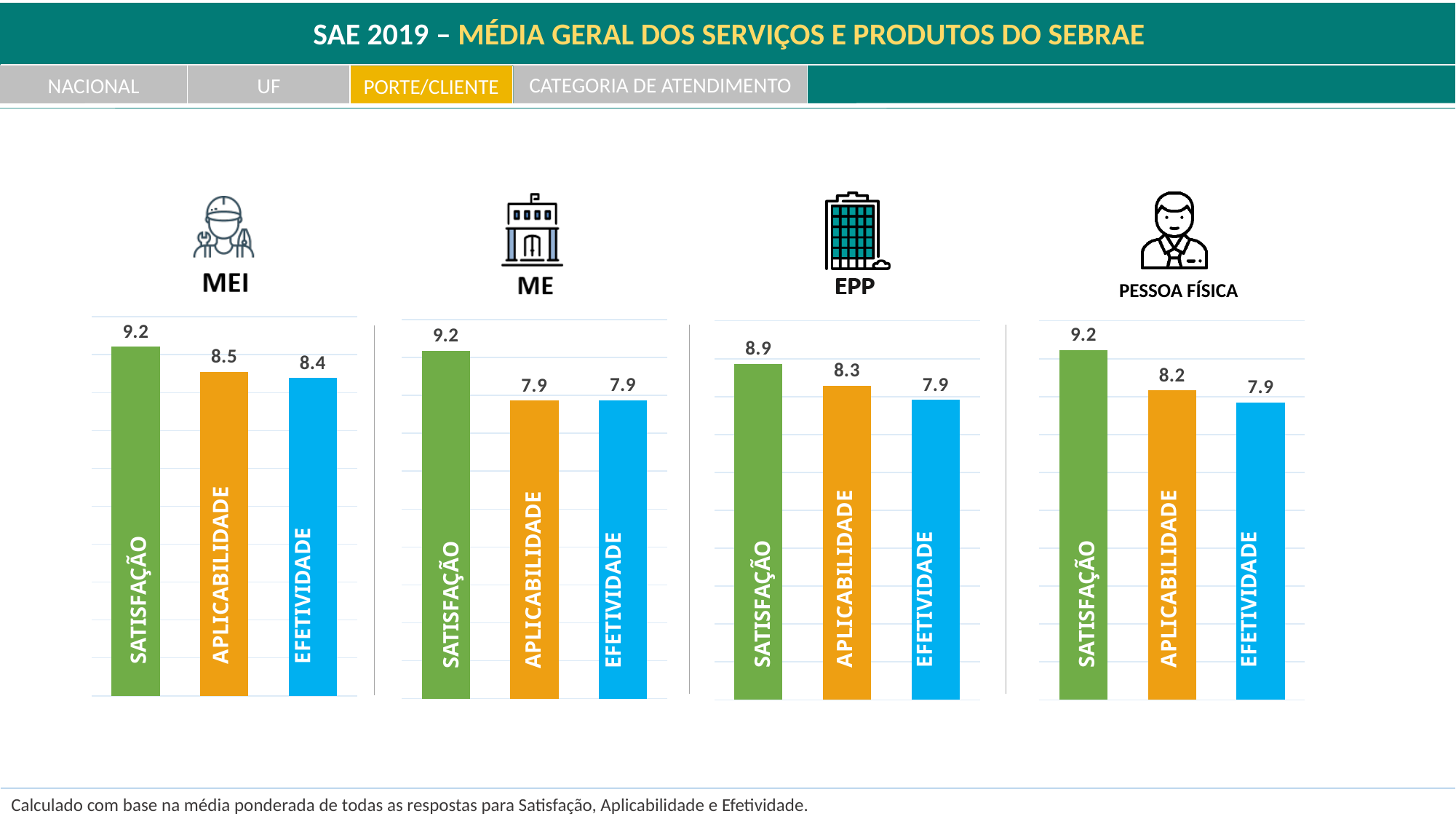
In the MEI chart, what is the difference between SATISFAÇÃO and APLICABILIDADE? 0.7 In the MEI chart, which category has the lowest value? EFETIVIDADE What type of chart is used for the PESSOA FÍSICA data? Bar chart In the EPP chart, what is the value for SATISFAÇÃO? 8.9 In the EPP chart, which category has the highest value? SATISFAÇÃO Which is larger: APLICABILIDADE in the MEI chart or APLICABILIDADE in the EPP chart? MEI How many bars are in the ME chart? 3 In the ME chart, what is the value for APLICABILIDADE? 7.9 In the PESSOA FÍSICA chart, what is the value for APLICABILIDADE? 8.2 In the EPP chart, what is the difference between APLICABILIDADE and EFETIVIDADE? 0.4 In the ME chart, do the values rise or fall from SATISFAÇÃO to EFETIVIDADE? Fall In the MEI chart, what is the value for SATISFAÇÃO? 9.2